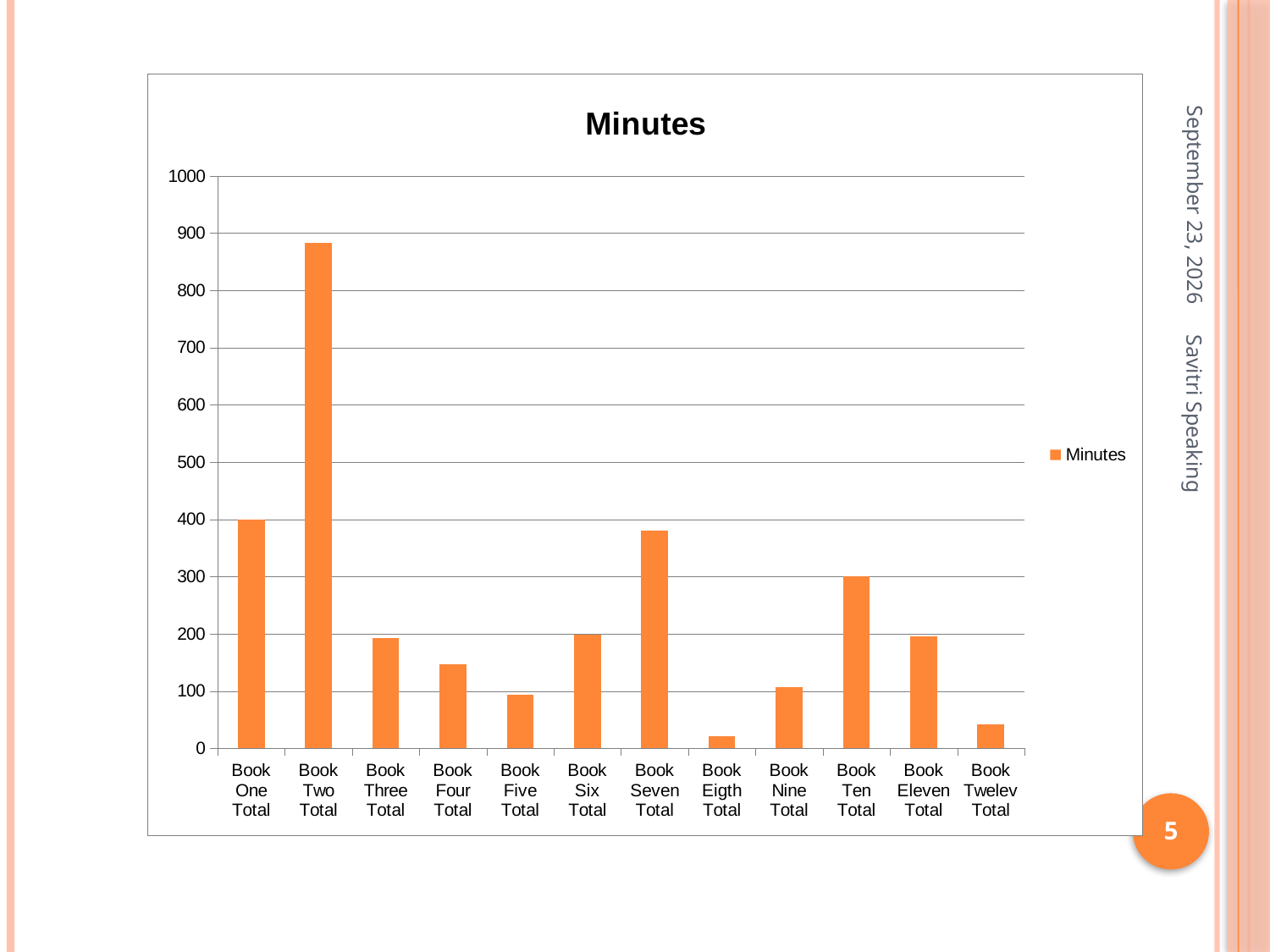
Which is larger, the value for Book Seven Total or Book Ten Total? Book Seven Total Is the value for Book Four Total greater or less than 100? greater Is the value for Book Seven Total greater or less than 400? less What is the title of the chart? Minutes Is the value for Book Two Total greater or less than 800? greater How many categories (books) are plotted on the x axis? 12 Which book has the highest total minutes? Book Two Total What type of chart is shown on the slide? bar chart Which book has the lowest total minutes? Book Eigth Total How many series does the legend list? 1